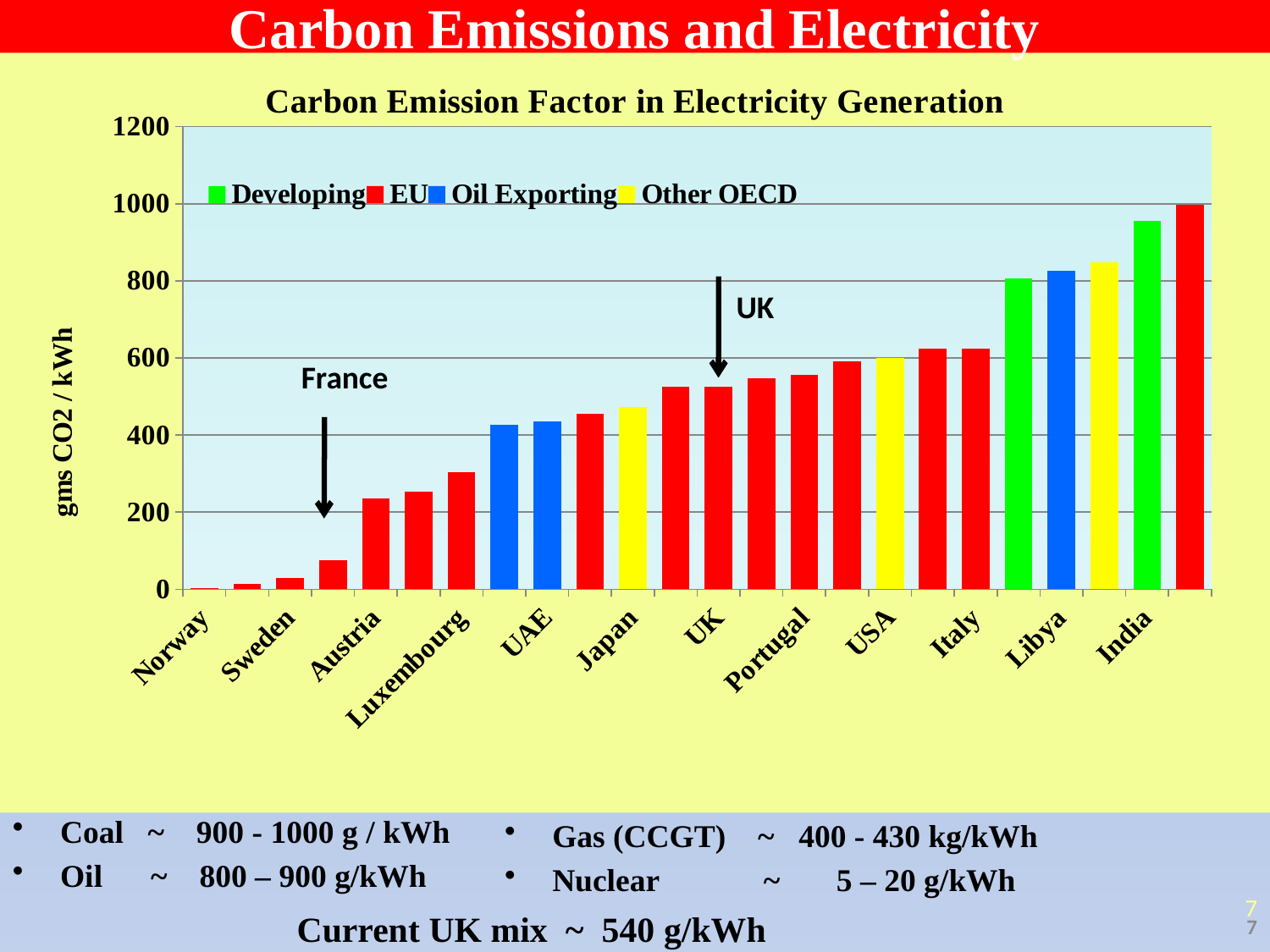
Is the value for India greater or less than 800? greater Is the value for Portugal greater or less than 400? greater How many series does the chart legend list? 4 Which country has the lowest carbon emission factor in the chart? Norway How many country labels are printed along the x axis? 12 Which has the larger carbon emission factor, the UK or Japan? UK Is the value for the UK greater or less than 600? less What kind of chart is shown on the slide? bar chart What colour are the EU bars in the chart? red What is the title of the chart? Carbon Emission Factor in Electricity Generation Do the bar values rise or fall from left to right along the x axis? rise